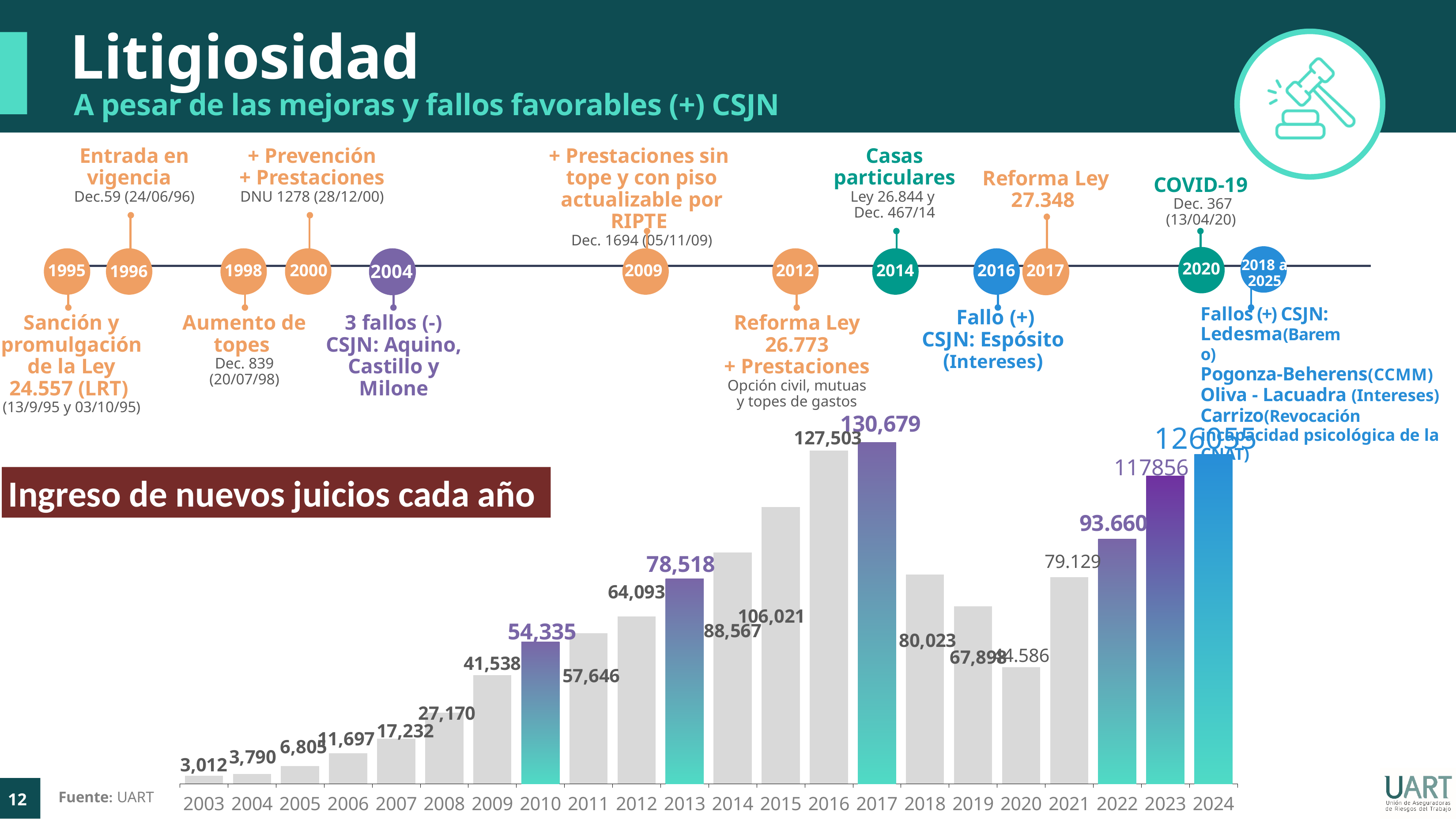
In the 'Ingreso de nuevos juicios cada año' chart, what is the difference between the values for 2013 and 2012? 14,425 How many years are shown on the x axis of the 'Ingreso de nuevos juicios cada año' chart? 22 In the 'Ingreso de nuevos juicios cada año' chart, what is the value for 2003? 3,012 In the 'Ingreso de nuevos juicios cada año' chart, what is the difference between the values for 2017 and 2016? 3,176 In the 'Ingreso de nuevos juicios cada año' chart, do the values rise or fall from 2003 to 2017? rise In the 'Ingreso de nuevos juicios cada año' chart, what is the value for 2017? 130,679 In the 'Ingreso de nuevos juicios cada año' chart, which is larger, the value for 2015 or the value for 2018? 2015 In the 'Ingreso de nuevos juicios cada año' chart, what is the value for 2010? 54,335 In the 'Ingreso de nuevos juicios cada año' chart, what is the value for 2022? 93.660 In the 'Ingreso de nuevos juicios cada año' chart, which year has the lowest value? 2003 In the 'Ingreso de nuevos juicios cada año' chart, which year has the highest value? 2017 What kind of chart is shown under the heading 'Ingreso de nuevos juicios cada año'? bar chart